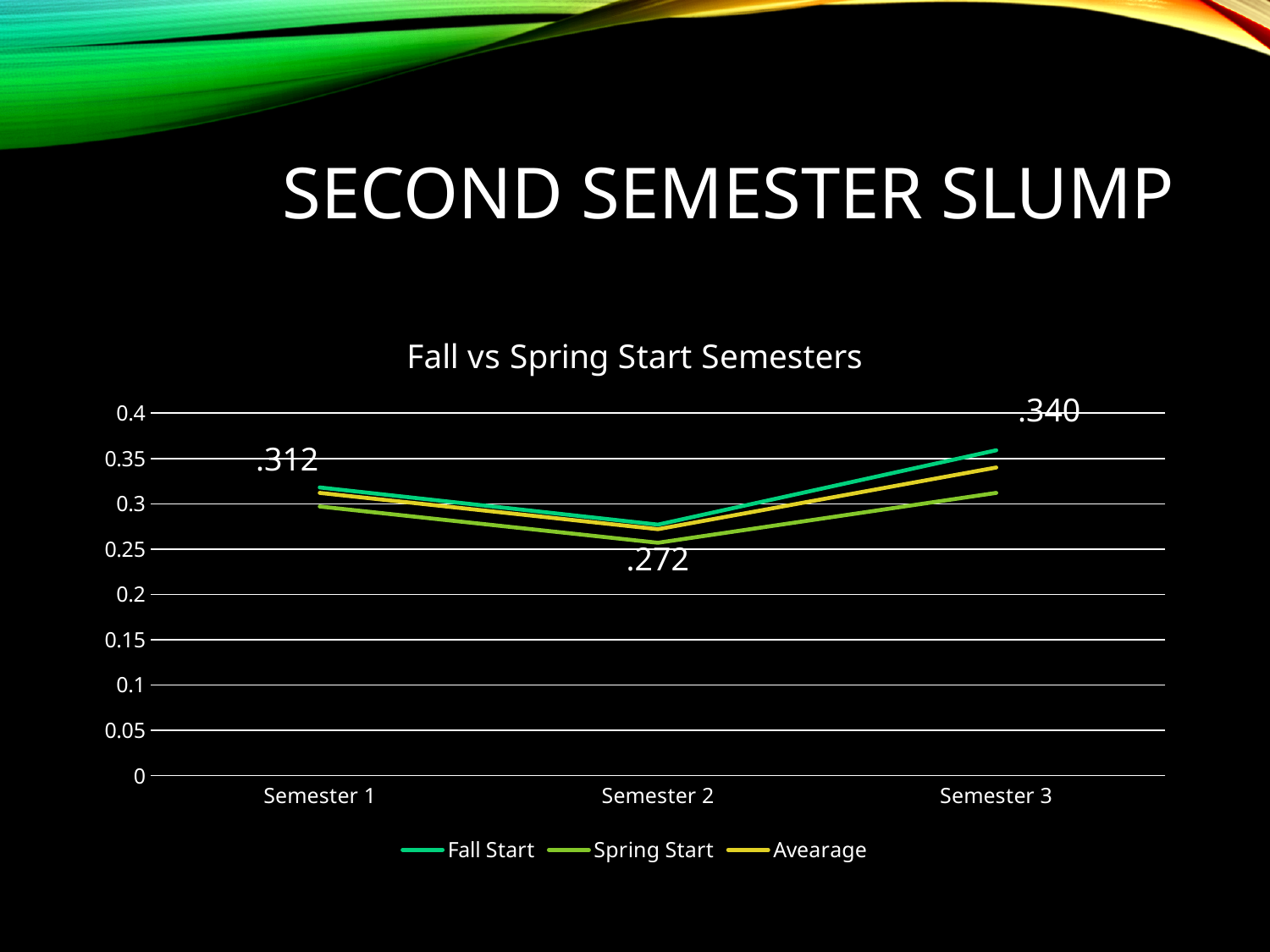
At Semester 3, which is higher, Fall Start or Spring Start? Fall Start What value is labelled at Semester 1? .312 Which semester has the highest labelled value? Semester 3 How many semesters are shown on the x axis? 3 Which semester has the lowest labelled value? Semester 2 What value is labelled at Semester 2? .272 Is the Fall Start value at Semester 3 greater or less than 0.35? greater What is the difference between the labelled values at Semester 3 and Semester 2? .068 What type of chart is shown on the slide? line chart What value is labelled at Semester 3? .340 What is the title of the chart? Fall vs Spring Start Semesters How many series does the legend list? 3